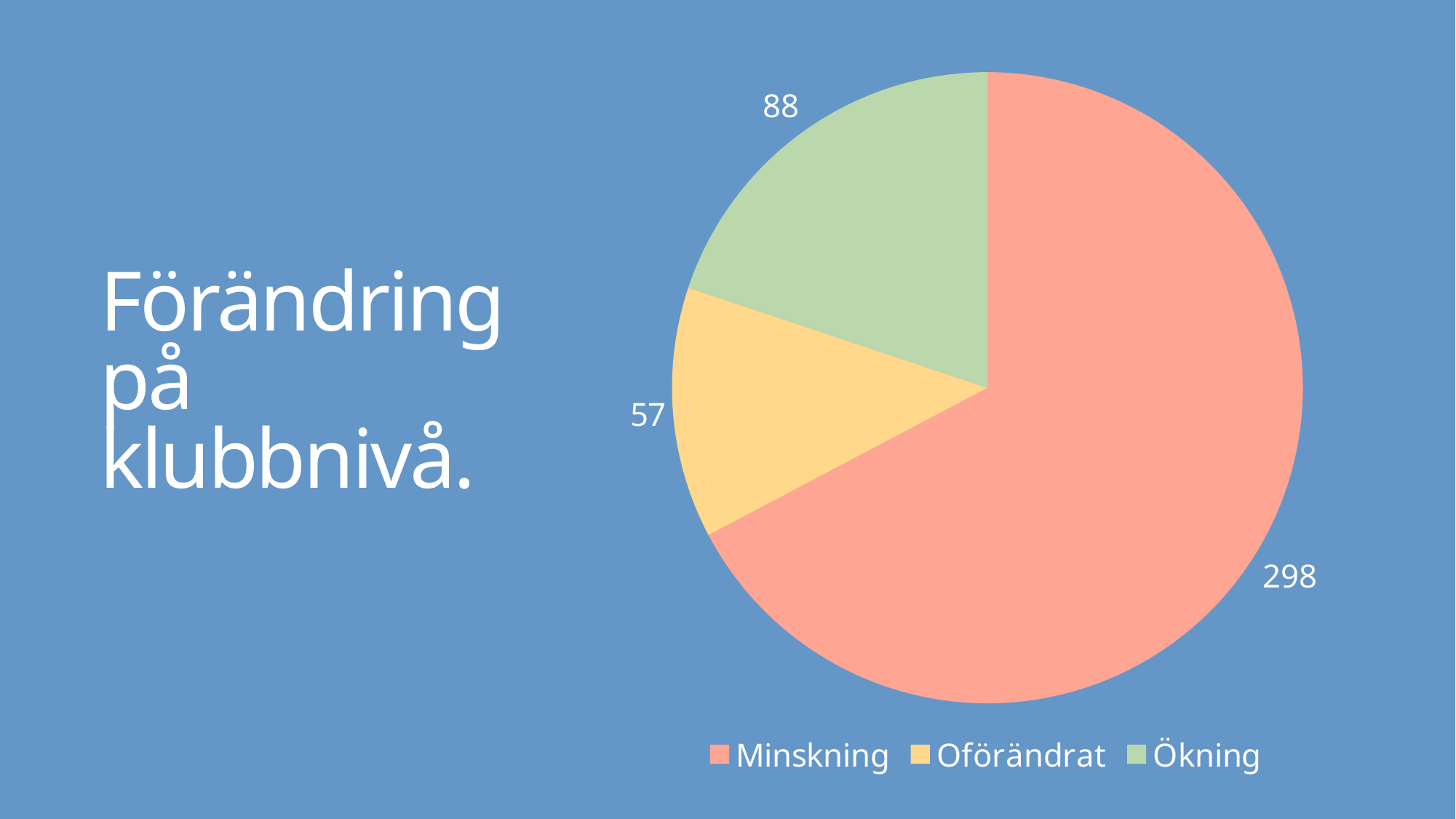
Which category has the smallest slice? Oförändrat What kind of chart is shown on the slide? Pie chart What is the value for Oförändrat? 57 What is the value for Ökning? 88 What is the difference between the values for Minskning and Ökning? 210 What is the value for Minskning? 298 How many categories does the pie chart have? 3 What is the total of all slices in the pie chart? 443 Which category has the largest slice? Minskning Which is larger, the value for Ökning or the value for Oförändrat? Ökning What is the difference between the values for Ökning and Oförändrat? 31 Which colour represents Ökning in the legend? Green